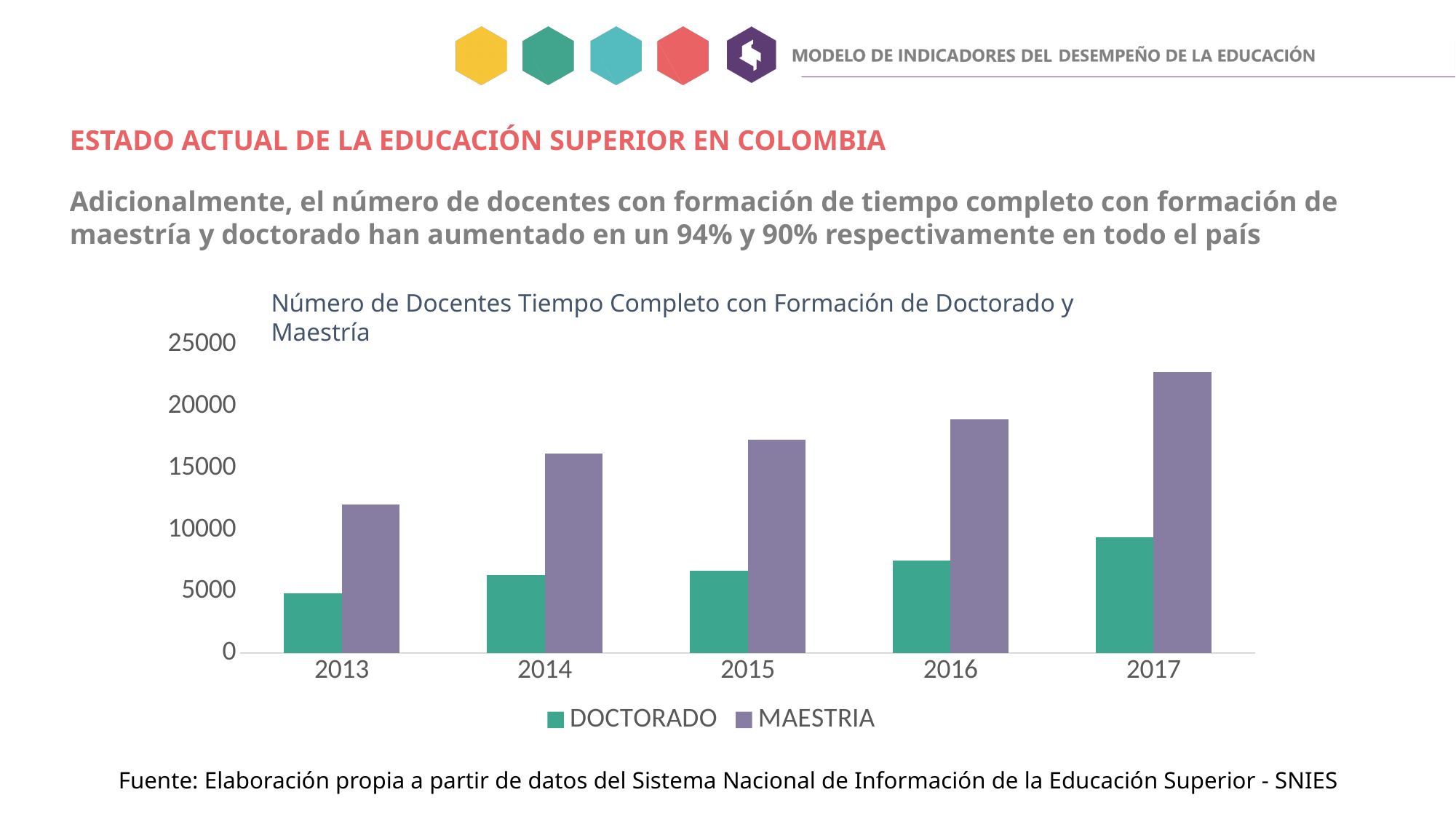
Is the DOCTORADO value for 2016 greater or less than 5000? greater How many years are shown on the x axis? 5 Is the MAESTRIA value for 2014 greater or less than 15000? greater What kind of chart is shown on the slide? Bar chart What is the title of the chart? Número de Docentes Tiempo Completo con Formación de Doctorado y Maestría In which year is the MAESTRIA value highest? 2017 Is the MAESTRIA value for 2017 greater or less than 20000? greater In 2015, which is larger, DOCTORADO or MAESTRIA? MAESTRIA In which year is the DOCTORADO value lowest? 2013 How many series does the legend list? 2 Do the MAESTRIA values rise or fall from 2013 to 2017? Rise